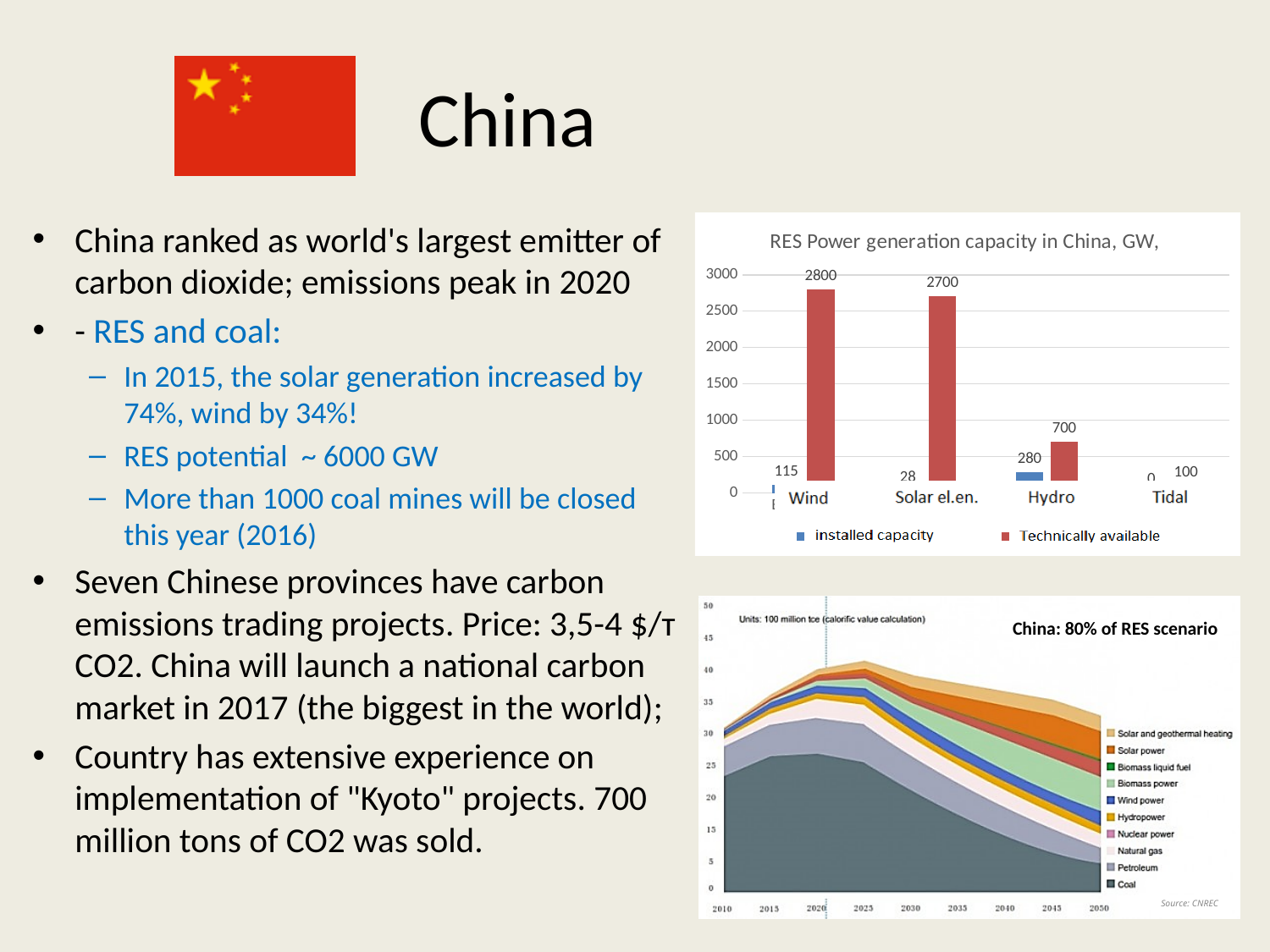
What kind of chart is the 'RES Power generation capacity in China, GW' chart? bar chart In the 'RES Power generation capacity in China, GW' chart, which category has the lowest installed capacity? Tidal In the 'RES Power generation capacity in China, GW' chart, which category has the highest technically available capacity? Wind In the 'RES Power generation capacity in China, GW' chart, how many categories are shown on the x axis? 4 In the 'China: 80% of RES scenario' chart, what is the source cited below the legend? CNREC In the 'China: 80% of RES scenario' chart, what is the first year shown on the x axis? 2010 In the 'RES Power generation capacity in China, GW' chart, what is the installed capacity for Solar el.en.? 28 In the 'RES Power generation capacity in China, GW' chart, what is the difference between the technically available and installed capacity for Hydro? 420 In the 'RES Power generation capacity in China, GW' chart, which is larger: the installed capacity for Wind or for Hydro? Hydro In the 'RES Power generation capacity in China, GW' chart, what is the installed capacity for Hydro? 280 In the 'RES Power generation capacity in China, GW' chart, what is the technically available capacity for Wind? 2800 In the 'RES Power generation capacity in China, GW' chart, how many series does the legend list? 2